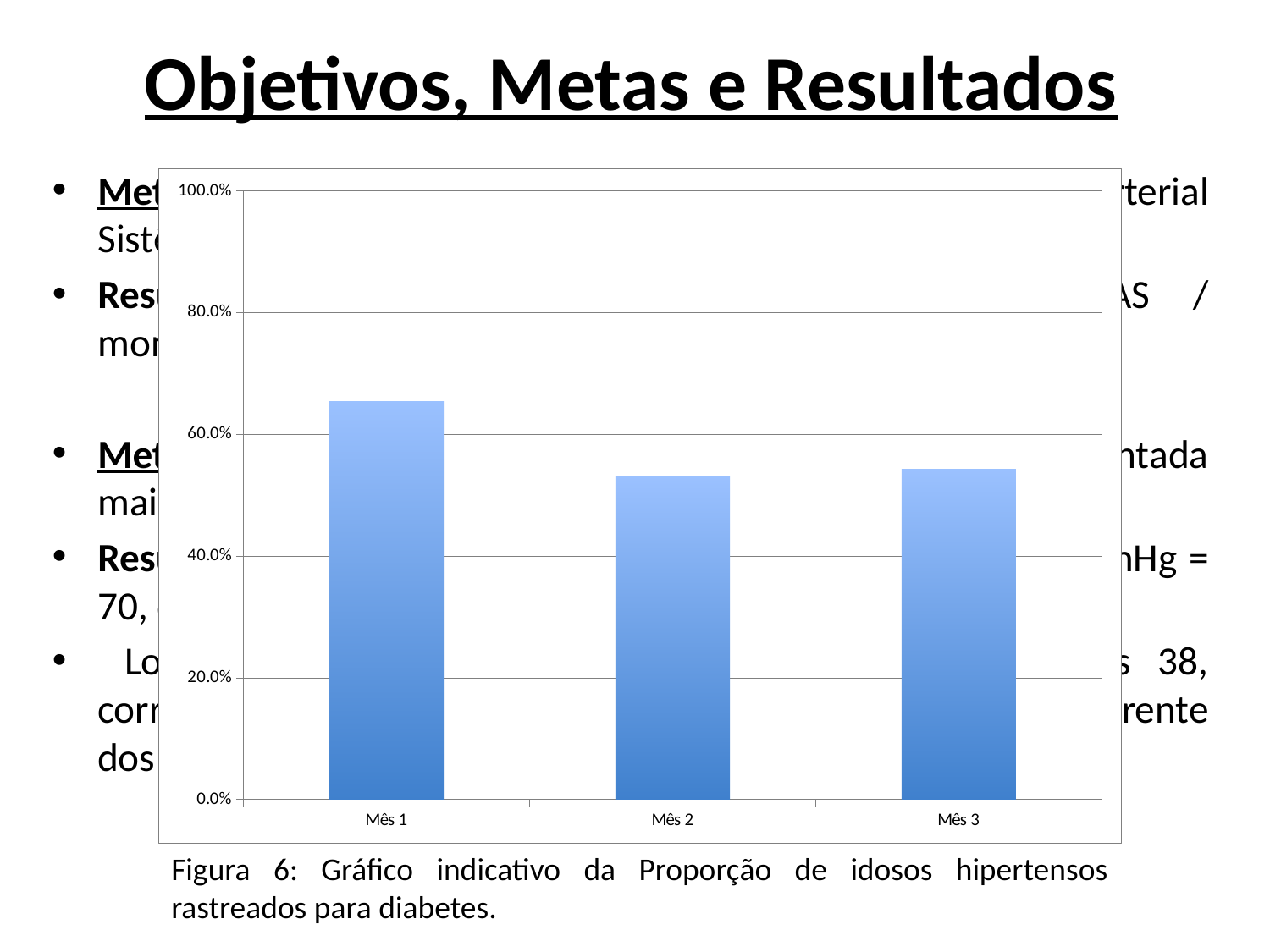
Which is larger, the value for Mês 1 or the value for Mês 3? Mês 1 Is the value for Mês 1 greater or less than 80.0%? less According to the caption, what does the chart (Figura 6) indicate? Proporção de idosos hipertensos rastreados para diabetes Is the value for Mês 2 greater or less than 60.0%? less Is the value for Mês 3 greater or less than 60.0%? less Which month has the highest value in the chart? Mês 1 How many categories (months) are plotted on the x axis of the chart? 3 What kind of chart is shown on the slide? Bar chart Which is larger, the value for Mês 1 or the value for Mês 2? Mês 1 Does the value rise or fall from Mês 1 to Mês 2? Fall